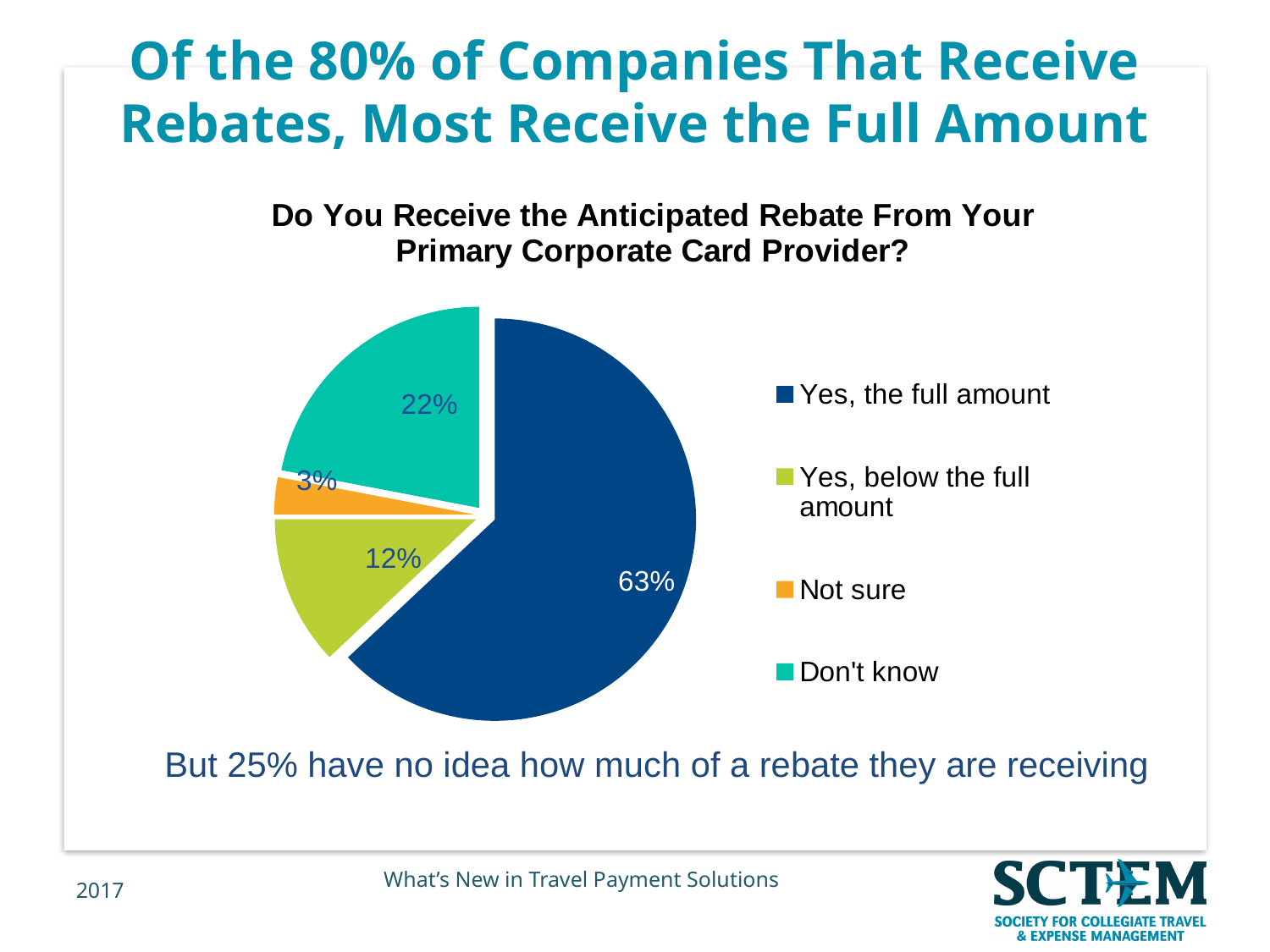
Which is larger: the share for "Don't know" or the share for "Yes, below the full amount"? Don't know What share of respondents answered "Not sure"? 3% Which response has the smallest slice of the pie? Not sure How many slices does the pie chart have? 4 What share of respondents answered "Yes, the full amount"? 63% What share of respondents answered "Don't know"? 22% What kind of chart is shown on the slide? pie chart What is the title of the pie chart? Do You Receive the Anticipated Rebate From Your Primary Corporate Card Provider? What is the combined share of "Not sure" and "Don't know"? 25% Which response has the largest slice of the pie? Yes, the full amount What is the difference in percentage points between "Yes, the full amount" and "Don't know"? 41 What share of respondents answered "Yes, below the full amount"? 12%